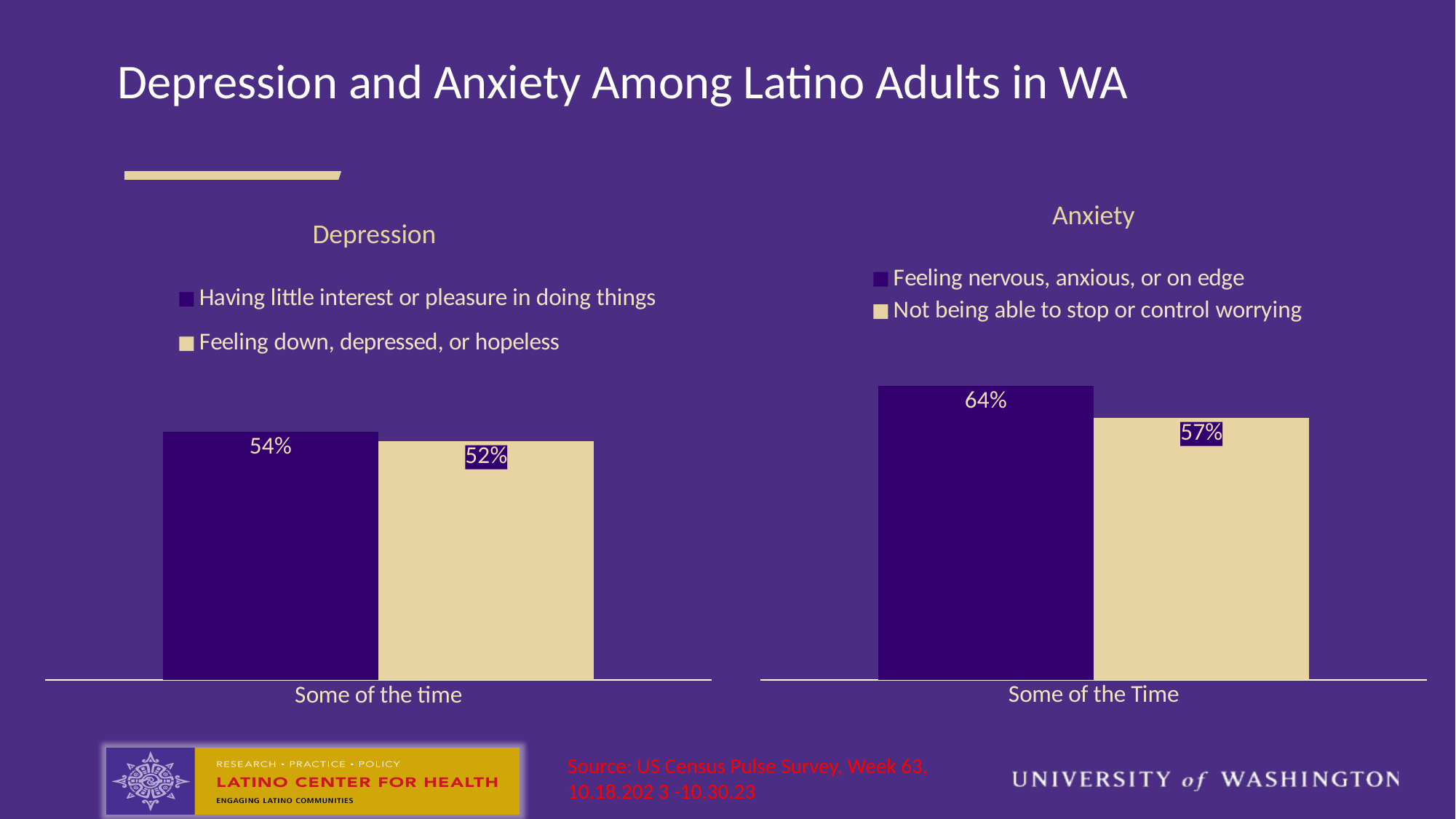
In the Depression chart, which series has the lower value? Feeling down, depressed, or hopeless What is the x-axis category label shown in the Depression chart? Some of the time Is the value for "Feeling nervous, anxious, or on edge" in the Anxiety chart larger or smaller than the value for "Having little interest or pleasure in doing things" in the Depression chart? larger In the Anxiety chart, which series has the higher value? Feeling nervous, anxious, or on edge In the Depression chart, what is the difference between the two bars' values? 2% In the Depression chart, what is the value for "Feeling down, depressed, or hopeless"? 52% In the Anxiety chart, what is the value for "Not being able to stop or control worrying"? 57% How many series does the legend of the Depression chart list? 2 In the Depression chart, what is the value for "Having little interest or pleasure in doing things"? 54% In the Anxiety chart, what is the difference between the values for "Feeling nervous, anxious, or on edge" and "Not being able to stop or control worrying"? 7% In the Anxiety chart, what is the value for "Feeling nervous, anxious, or on edge"? 64% What kind of chart is the Anxiety chart? bar chart